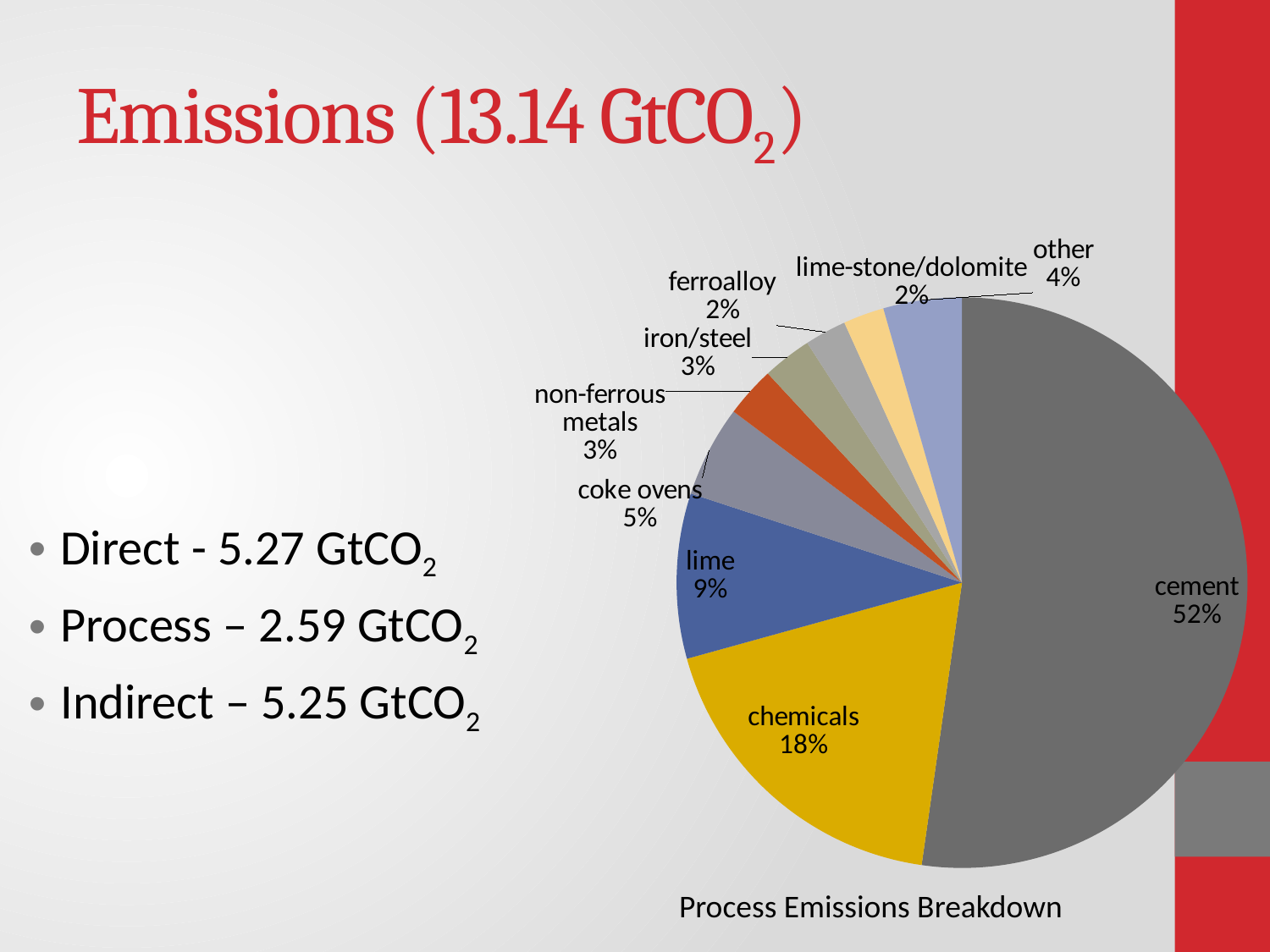
How many slices does the pie chart have? 9 What type of chart is shown on the slide? pie chart What is the difference in share between cement and chemicals? 34% What share of process emissions does iron/steel account for? 3% What share of process emissions does chemicals account for? 18% Which category has the largest share of process emissions? cement What share of process emissions does lime account for? 9% What share of process emissions does cement account for? 52% What share of process emissions does the 'other' slice account for? 4% What share of process emissions do coke ovens account for? 5% Which has a larger share of process emissions, lime or coke ovens? lime What is the title of the chart? Process Emissions Breakdown